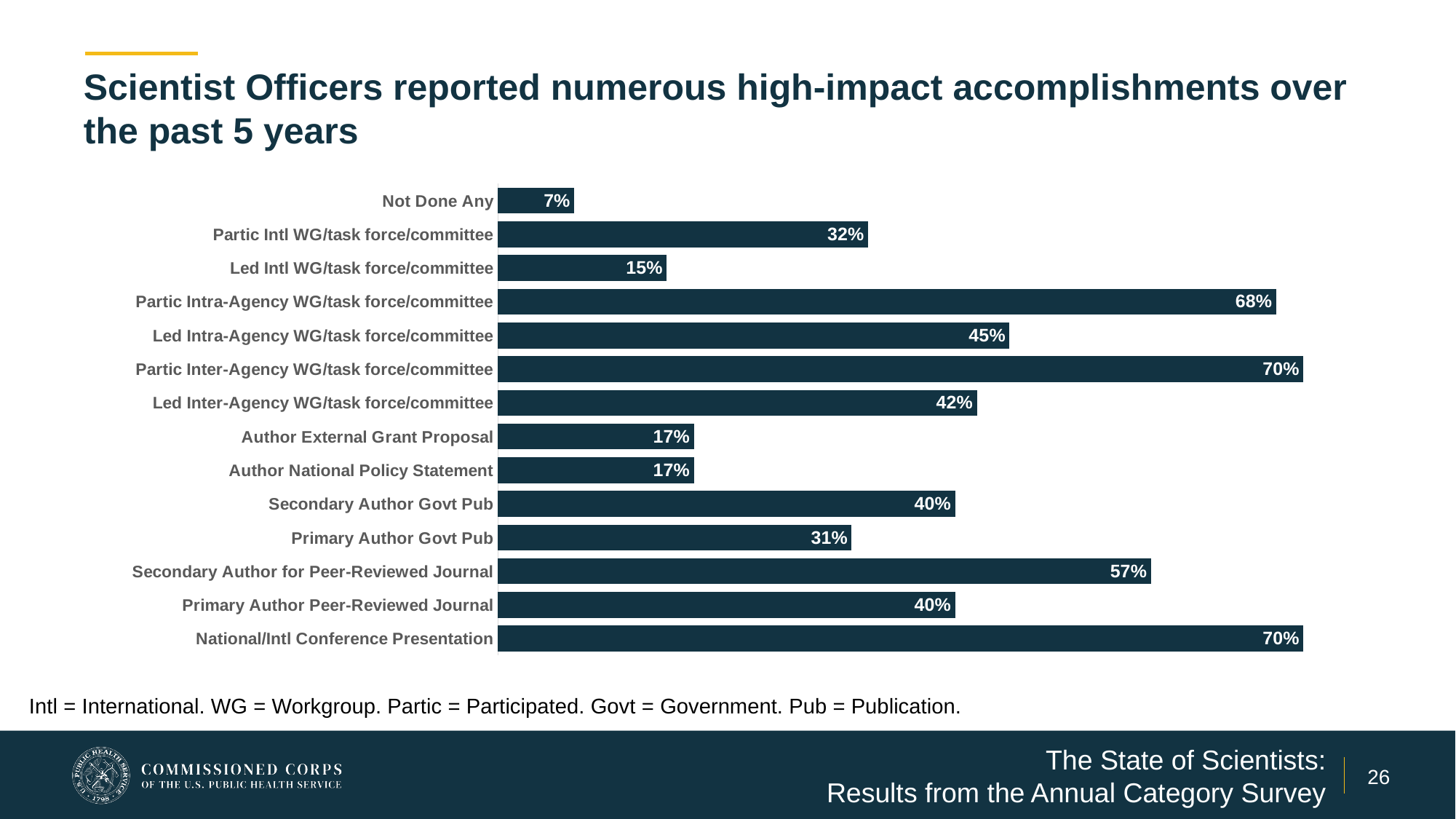
What is the difference between Partic Intl WG/task force/committee and Led Intl WG/task force/committee? 17% Which category has the lowest value on the chart? Not Done Any Which is larger: Secondary Author Govt Pub or Primary Author Govt Pub? Secondary Author Govt Pub What is the value shown for Primary Author Govt Pub? 31% What is the value for Secondary Author for Peer-Reviewed Journal? 57% What percentage reported Led Intl WG/task force/committee? 15% What does the abbreviation WG stand for according to the note below the chart? Workgroup What is the difference between Partic Inter-Agency WG/task force/committee and Led Inter-Agency WG/task force/committee? 28% How many categories are shown on the chart? 14 Which is larger: Led Intra-Agency WG/task force/committee or Led Inter-Agency WG/task force/committee? Led Intra-Agency WG/task force/committee What percentage of Scientist Officers reported participating in an Intra-Agency WG/task force/committee? 68% What type of chart is shown on the slide? Bar chart